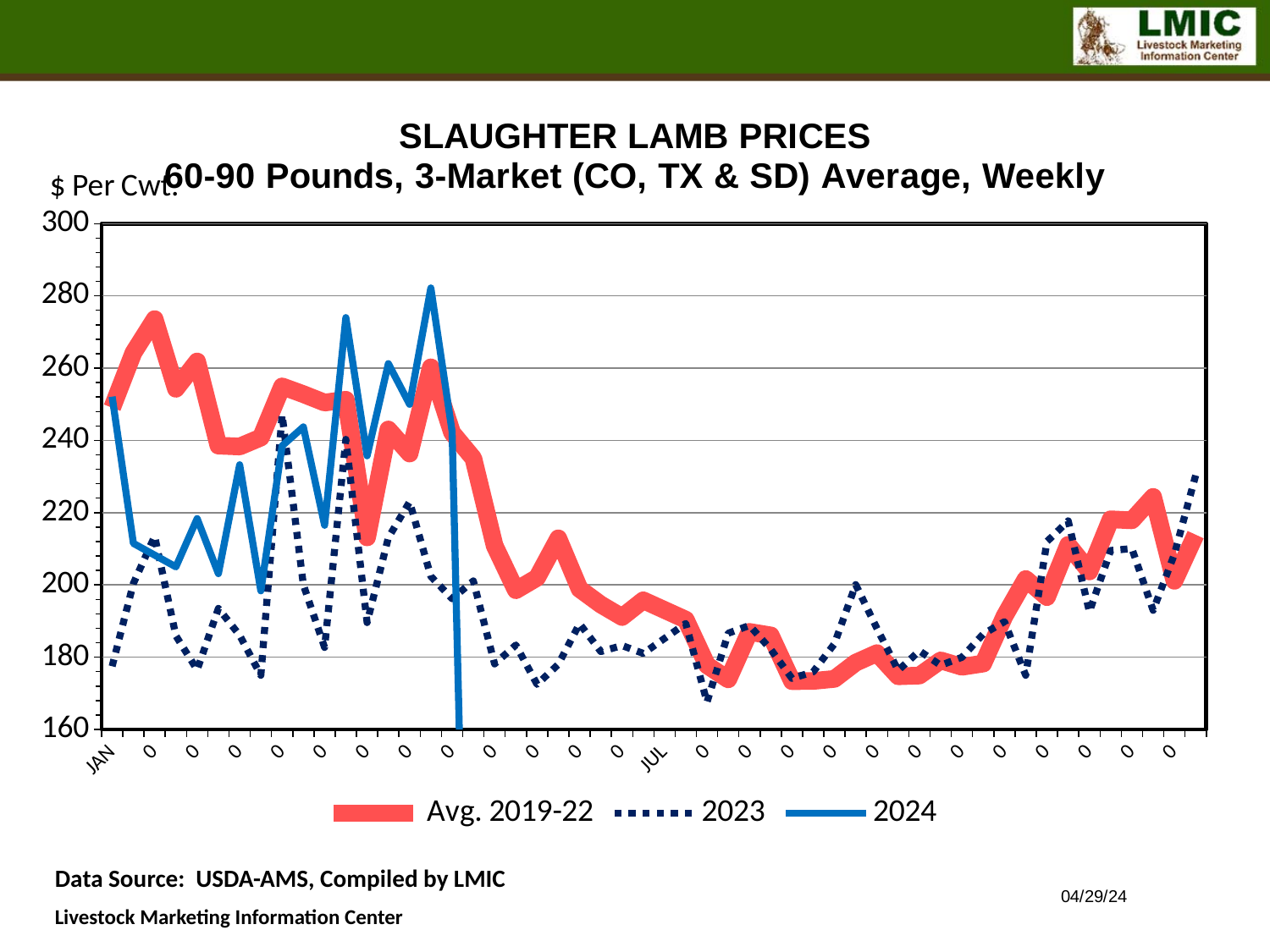
What unit is shown on the vertical axis of the chart? $ Per Cwt. Does the Avg. 2019-22 line generally rise or fall from JAN to JUL? Fall What type of chart is shown on the slide? Line chart Is the highest value of the 2024 line greater or less than 260? greater What are the three series listed in the legend? Avg. 2019-22, 2023, 2024 Is the value of the 2023 line at JAN greater or less than 200? less How many series does the legend list? 3 Which series reaches the highest value anywhere on the chart? 2024 Is the lowest value of the 2023 line greater or less than 180? less At JAN, which is higher: the Avg. 2019-22 line or the 2023 line? Avg. 2019-22 Does the 2023 line generally rise or fall from JUL to the end of the year? Rise